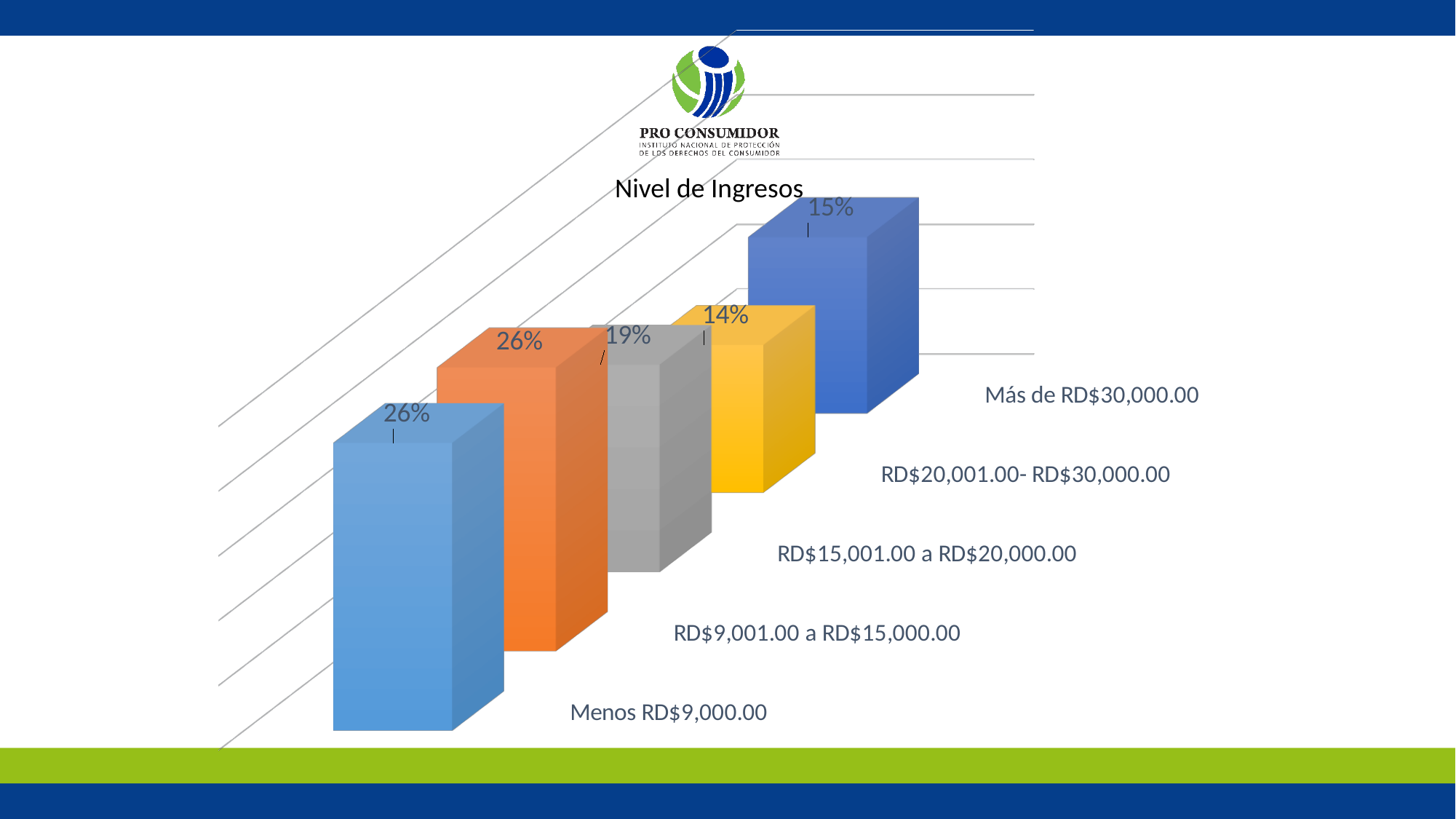
What is the difference between the values for Menos RD$9,000.00 and RD$15,001.00 a RD$20,000.00? 7% What is the value for Más de RD$30,000.00? 15% What kind of chart is shown on the slide? bar chart What is the difference between the values for Más de RD$30,000.00 and RD$20,001.00- RD$30,000.00? 1% What is the value for Menos RD$9,000.00? 26% What is the value for RD$15,001.00 a RD$20,000.00? 19% What is the value for RD$9,001.00 a RD$15,000.00? 26% Which category has the lowest value? RD$20,001.00- RD$30,000.00 What is the title of the chart? Nivel de Ingresos How many categories does the chart show? 5 Which is larger, the value for RD$15,001.00 a RD$20,000.00 or the value for Más de RD$30,000.00? RD$15,001.00 a RD$20,000.00 What is the value for RD$20,001.00- RD$30,000.00? 14%